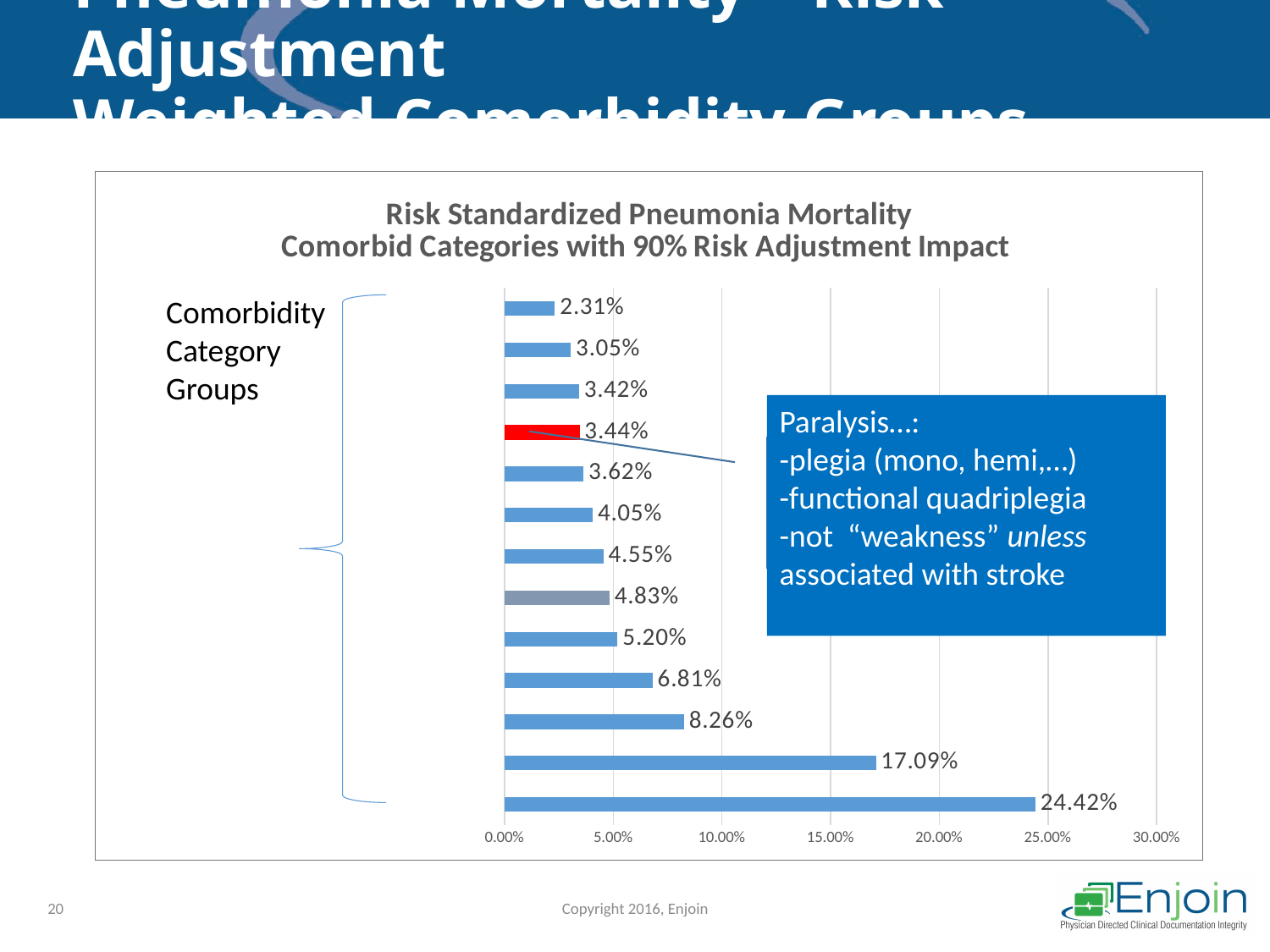
How many bars are plotted in the chart? 13 What is the largest value shown in the chart? 24.42% What kind of chart is shown on the slide? bar chart What is the difference between the two largest values in the chart (24.42% and 17.09%)? 7.33% What is the difference between the two smallest values in the chart (3.05% and 2.31%)? 0.74% Is the value of the red bar greater or less than 5.00%? less What value is labeled on the red bar in the chart? 3.44% What is the smallest value shown in the chart? 2.31% What is the highest tick value shown on the horizontal axis of the chart? 30.00% What value is labeled on the grey bar in the chart? 4.83% How many bars in the chart have values greater than 10.00%? 2 What is the title of the chart? Risk Standardized Pneumonia Mortality Comorbid Categories with 90% Risk Adjustment Impact